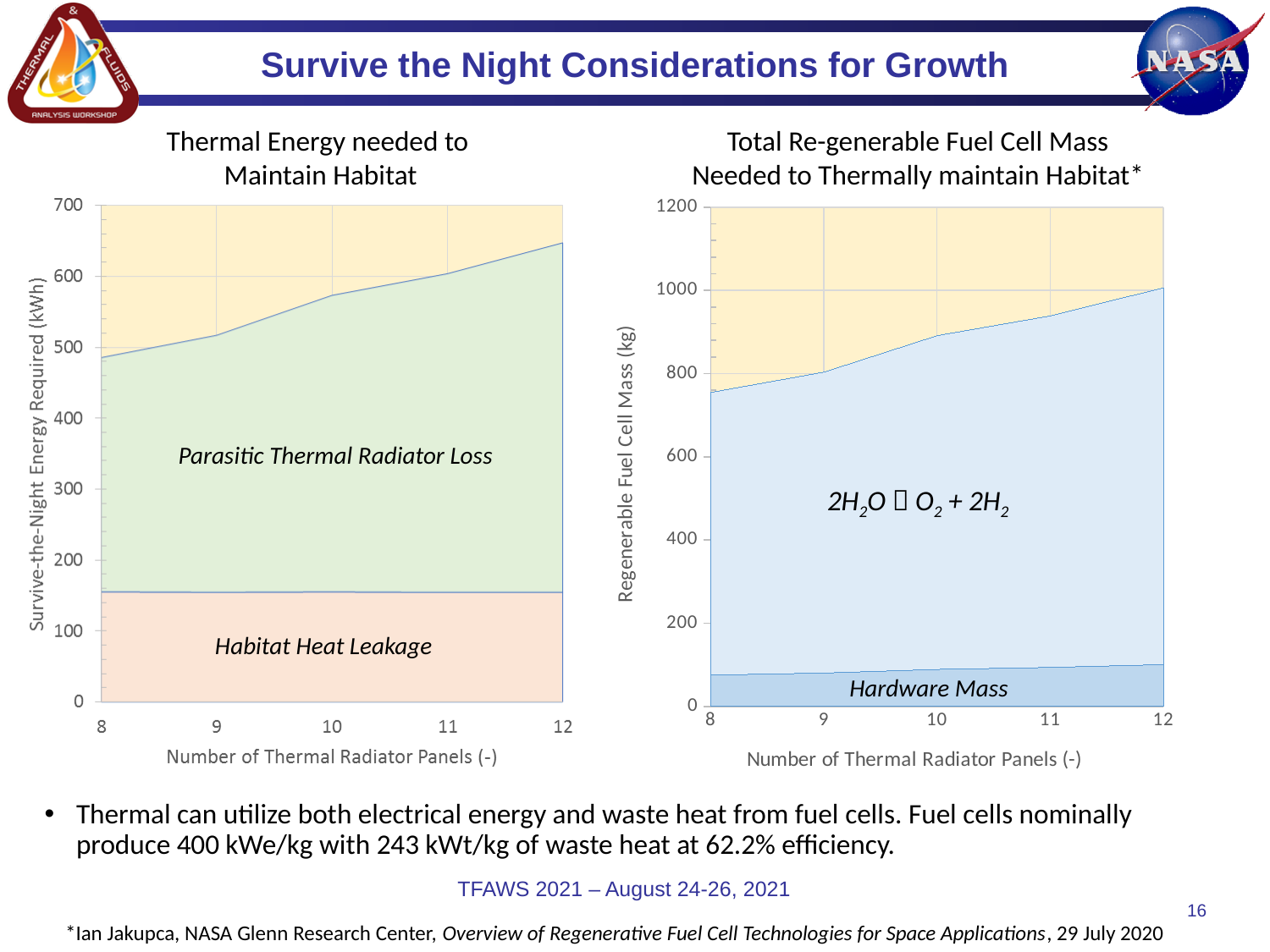
In the left chart, 'Thermal Energy needed to Maintain Habitat', is the total energy required at 12 panels greater or less than 600 kWh? greater In the right chart, 'Total Re-generable Fuel Cell Mass Needed to Thermally maintain Habitat', does the total fuel cell mass rise or fall as the number of thermal radiator panels increases? rise In the right chart, 'Total Re-generable Fuel Cell Mass Needed to Thermally maintain Habitat', is the total mass at 8 panels greater or less than 800 kg? less In the left chart, 'Thermal Energy needed to Maintain Habitat', what is the label of the green area above the Habitat Heat Leakage region? Parasitic Thermal Radiator Loss What kind of chart is the left chart, 'Thermal Energy needed to Maintain Habitat'? area chart In the right chart, 'Total Re-generable Fuel Cell Mass Needed to Thermally maintain Habitat', is the Hardware Mass at 12 panels greater or less than 200 kg? less How many values for the number of thermal radiator panels are labeled on the x axis of the left chart, 'Thermal Energy needed to Maintain Habitat'? 5 What is the y-axis label of the right chart, 'Total Re-generable Fuel Cell Mass Needed to Thermally maintain Habitat'? Regenerable Fuel Cell Mass (kg) In the left chart, 'Thermal Energy needed to Maintain Habitat', does the total energy required rise or fall as the number of thermal radiator panels increases from 8 to 12? rise